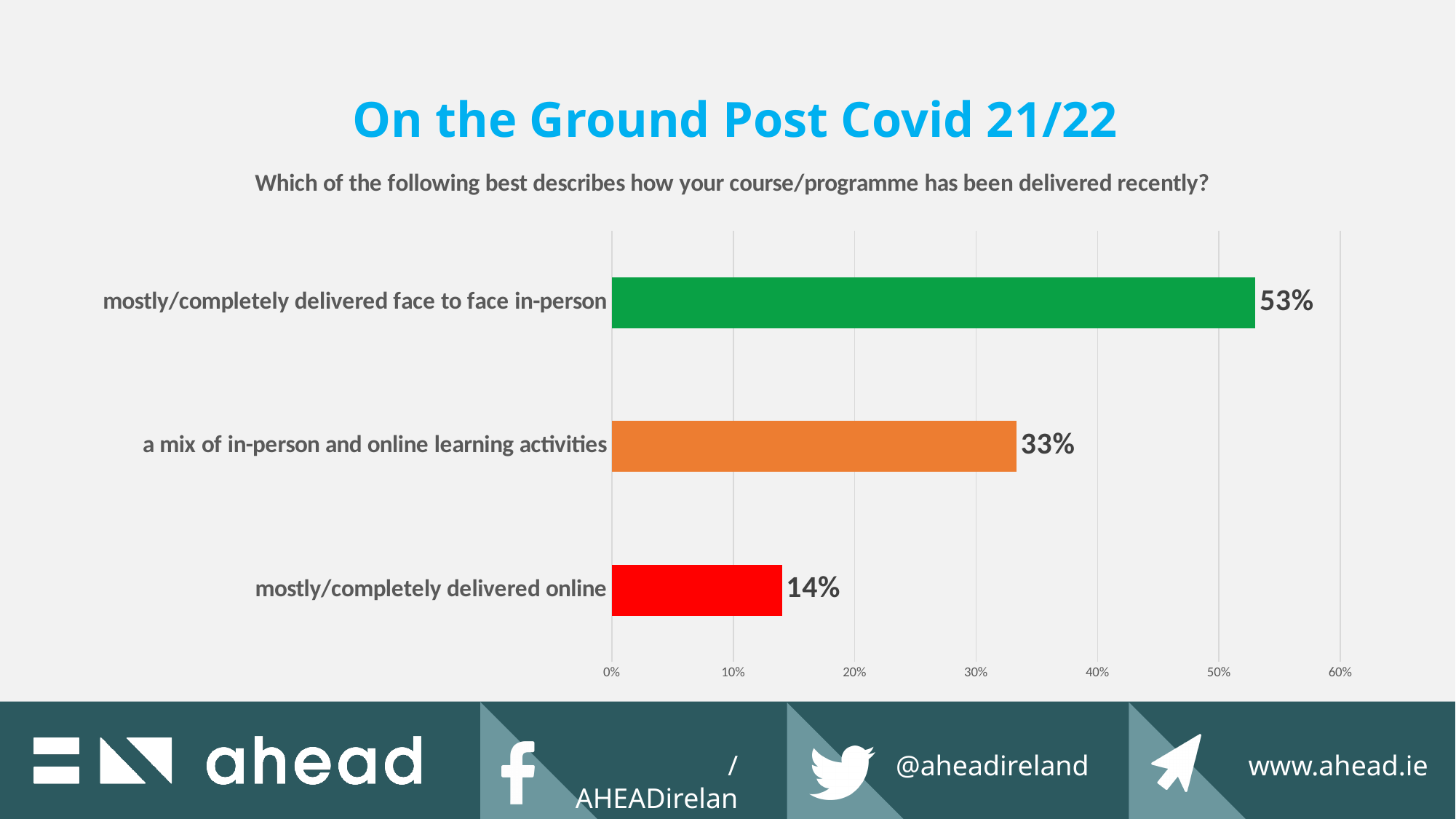
What percentage of respondents said their course was mostly/completely delivered online? 14% Which is larger: the percentage for a mix of in-person and online learning activities or for mostly/completely delivered online? a mix of in-person and online learning activities What type of chart is shown on the slide? bar chart How many delivery mode categories are shown in the chart? 3 What percentage of respondents said their course was mostly/completely delivered face to face in-person? 53% Which delivery mode has the lowest percentage? mostly/completely delivered online What is the difference in percentage points between face to face in-person delivery and a mix of in-person and online learning activities? 20 Which delivery mode has the highest percentage? mostly/completely delivered face to face in-person Is the value for a mix of in-person and online learning activities greater or less than 30%? greater What is the difference in percentage points between face to face in-person delivery and mostly/completely online delivery? 39 What colour is the bar for mostly/completely delivered online? red What percentage of respondents reported a mix of in-person and online learning activities? 33%